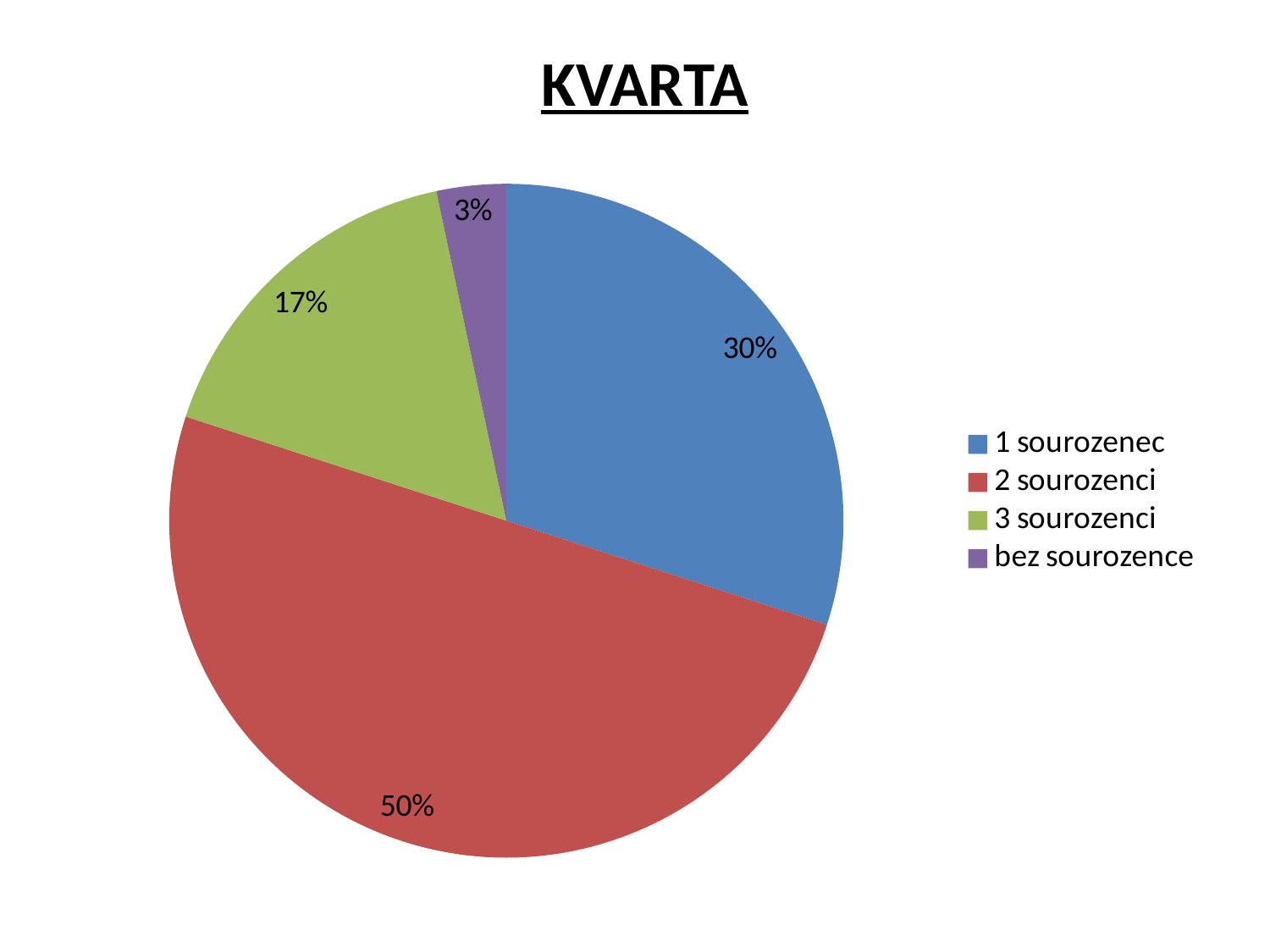
Which category has the largest slice of the pie? 2 sourozenci What percentage of the pie is '1 sourozenec'? 30% What percentage of the pie is 'bez sourozence'? 3% What percentage of the pie is '2 sourozenci'? 50% How many categories does the pie chart have? 4 What kind of chart is shown on the slide? pie chart What percentage of the pie is '3 sourozenci'? 17% Which is larger, the slice for '3 sourozenci' or the slice for 'bez sourozence'? 3 sourozenci Which category has the smallest slice of the pie? bez sourozence What colour is the slice for '3 sourozenci'? green What is the title of the chart? KVARTA What is the difference in percentage points between '2 sourozenci' and '1 sourozenec'? 20